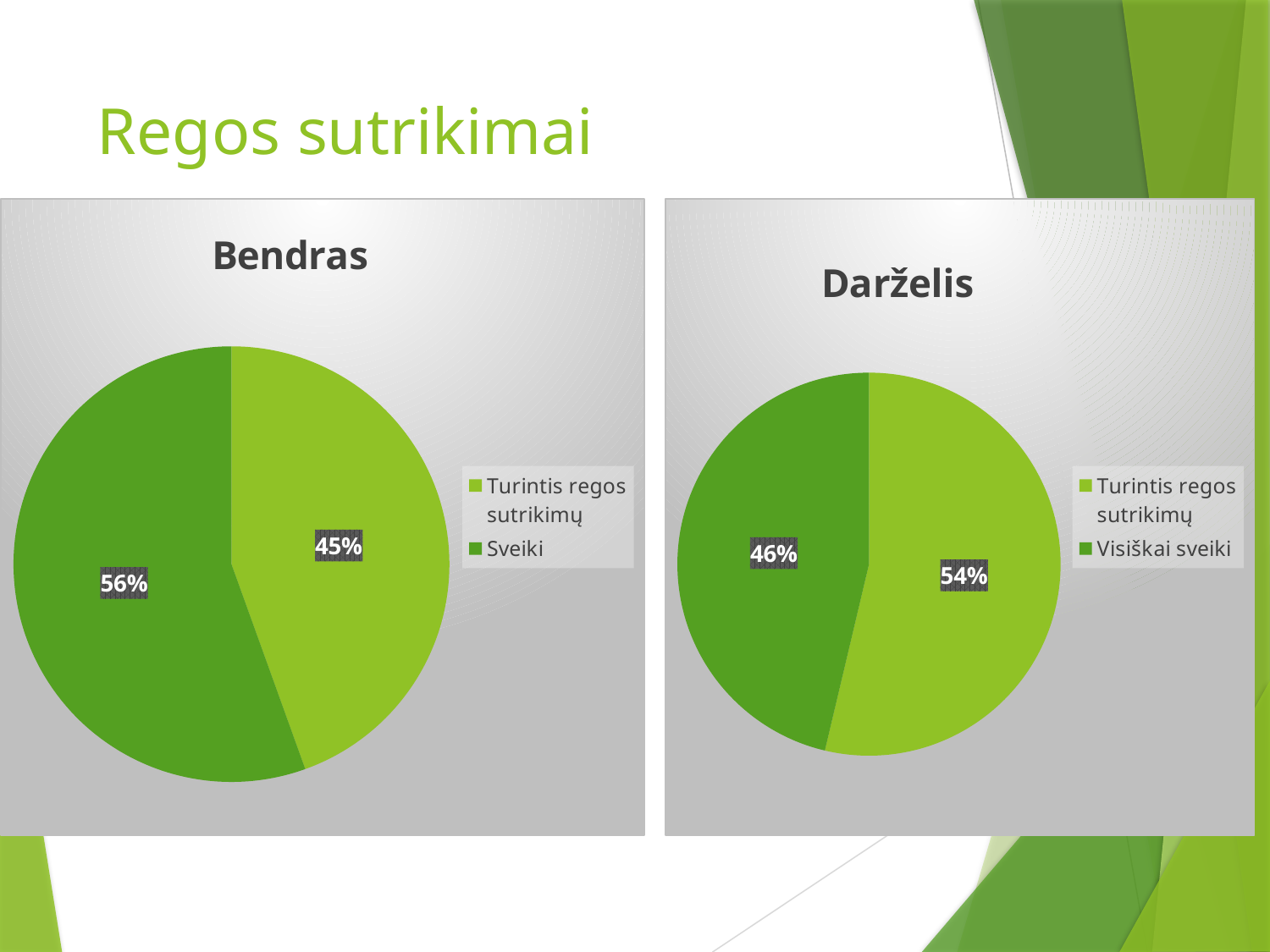
In the "Darželis" chart, what is the difference between the "Turintis regos sutrikimų" and "Visiškai sveiki" shares? 8% In the "Bendras" chart, what share is labelled for "Sveiki"? 56% In the "Bendras" chart, which slice is the largest? Sveiki How many entries does the legend of the "Bendras" chart list? 2 How many slices does the "Darželis" chart have? 2 In the "Darželis" chart, what share is labelled for "Turintis regos sutrikimų"? 54% In the "Darželis" chart, which is larger: "Turintis regos sutrikimų" or "Visiškai sveiki"? Turintis regos sutrikimų In the "Darželis" chart, what share is labelled for "Visiškai sveiki"? 46% In the "Bendras" chart, what share is labelled for "Turintis regos sutrikimų"? 45% What kind of chart is the "Bendras" chart? Pie chart In the "Darželis" chart, which slice is the smallest? Visiškai sveiki In the "Bendras" chart, what is the difference between the "Sveiki" and "Turintis regos sutrikimų" shares? 11%